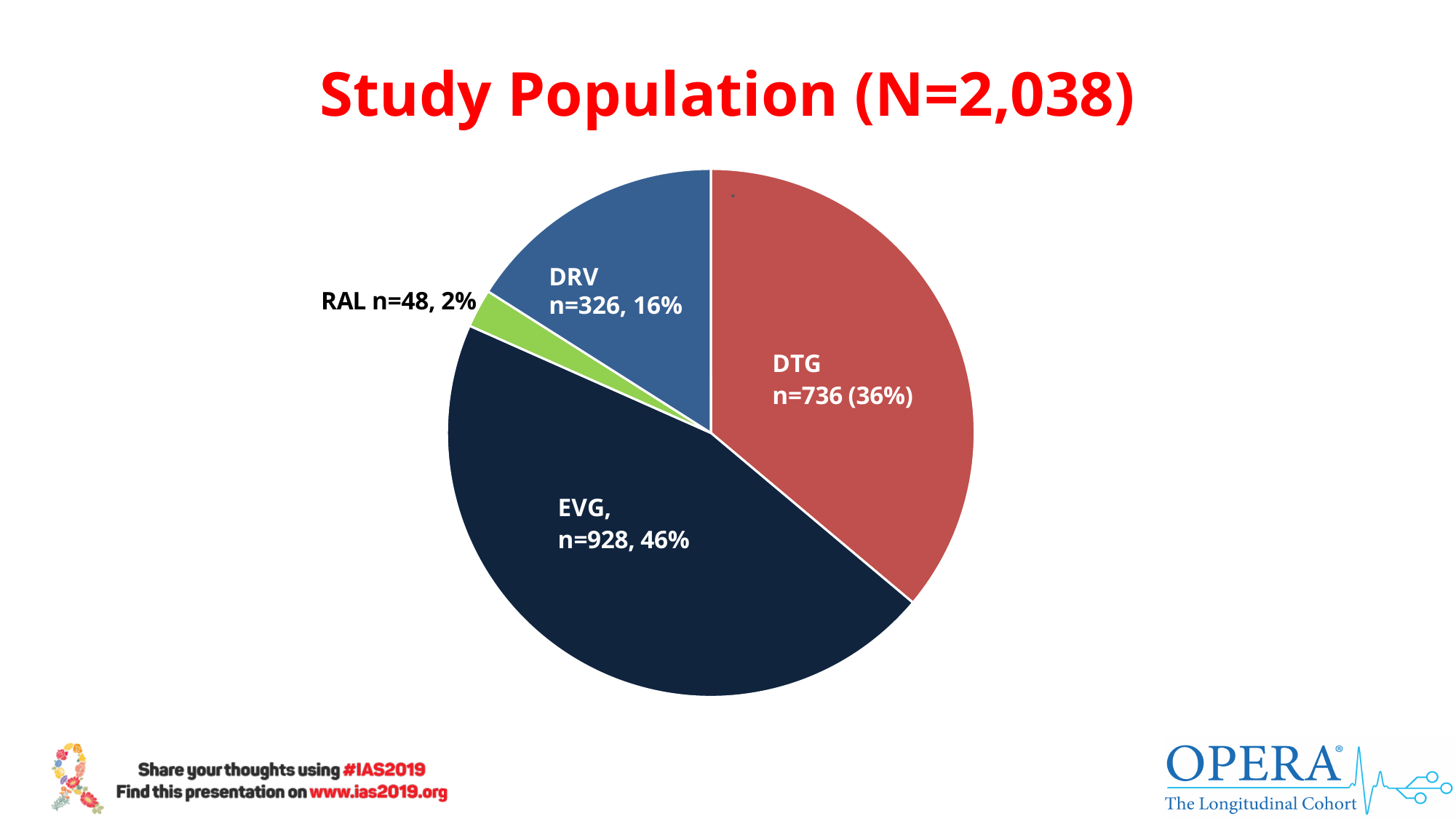
What is the n value for the DTG slice? 736 What is the difference in n between the EVG and DTG slices? 192 What is the n value for the RAL slice? 48 What share of the pie does the EVG slice represent? 46% Which slice is the smallest? RAL How many slices does the pie chart have? 4 What is the n value for the DRV slice? 326 What is the title of the chart? Study Population (N=2,038) Which slice is the largest? EVG What kind of chart is shown on the slide? pie chart What share of the pie does the DRV slice represent? 16% What is the n value for the EVG slice? 928